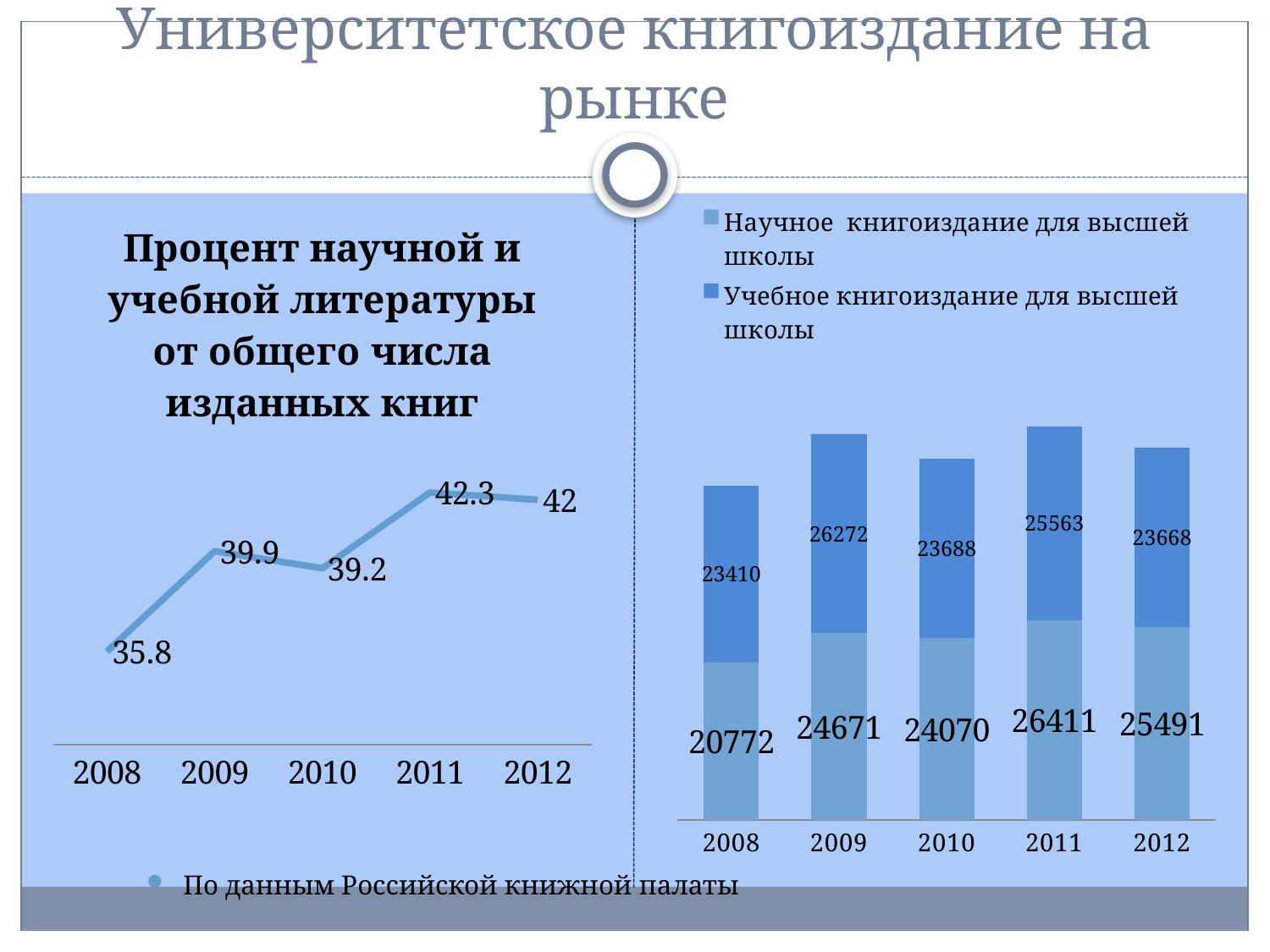
In the stacked bar chart on the right, which is larger in 2012: Научное книгоиздание для высшей школы or Учебное книгоиздание для высшей школы? Научное книгоиздание для высшей школы What kind of chart is shown on the right side of the slide? Stacked bar chart In the stacked bar chart on the right, what is the value for Учебное книгоиздание для высшей школы in 2009? 26272 In the line chart on the left, how many years are plotted? 5 In the line chart on the left, what is the difference between the values for 2011 and 2008? 6.5 In the stacked bar chart on the right, how many series does the legend list? 2 In the stacked bar chart on the right, what is the value for Научное книгоиздание для высшей школы in 2011? 26411 In the line chart on the left, what is the value for 2011? 42.3 In the line chart on the left, what is the value for 2008? 35.8 In the line chart on the left, which year has the lowest value? 2008 In the line chart on the left, which year has the highest value? 2011 In the stacked bar chart on the right, what is the total of the 2008 bar? 44182